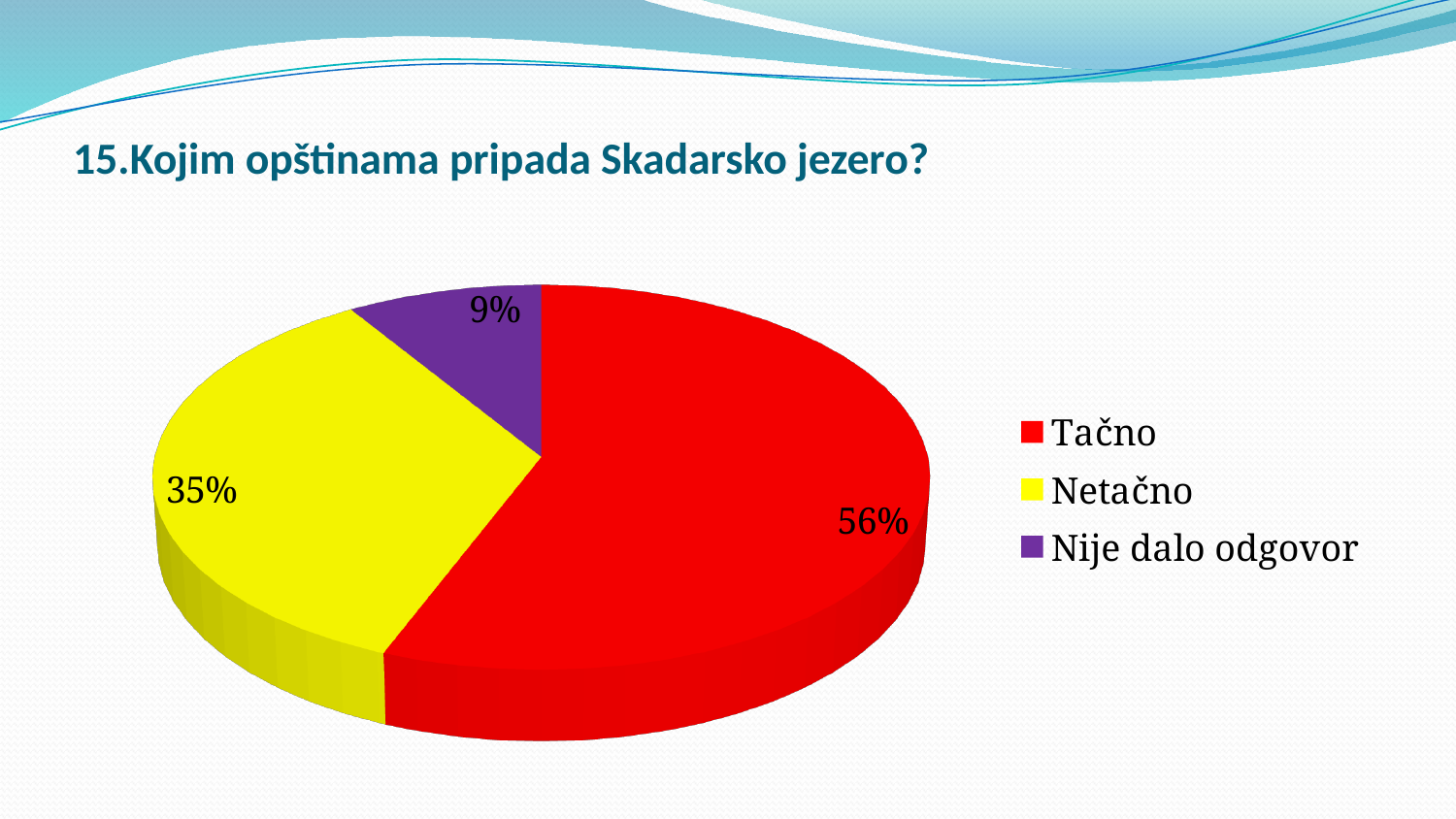
What colour is the slice for Netačno? yellow What is the title of the slide above the chart? 15.Kojim opštinama pripada Skadarsko jezero? Which category has the smallest slice of the pie? Nije dalo odgovor What share of the pie does Netačno have? 35% How many categories does the legend list? 3 What is the difference in percentage points between Netačno and Nije dalo odgovor? 26 What kind of chart is shown on the slide? pie chart What is the difference in percentage points between Tačno and Netačno? 21 Which is larger, the share for Netačno or the share for Nije dalo odgovor? Netačno What share of the pie does Tačno have? 56% What share of the pie does Nije dalo odgovor have? 9% Which category has the largest slice of the pie? Tačno